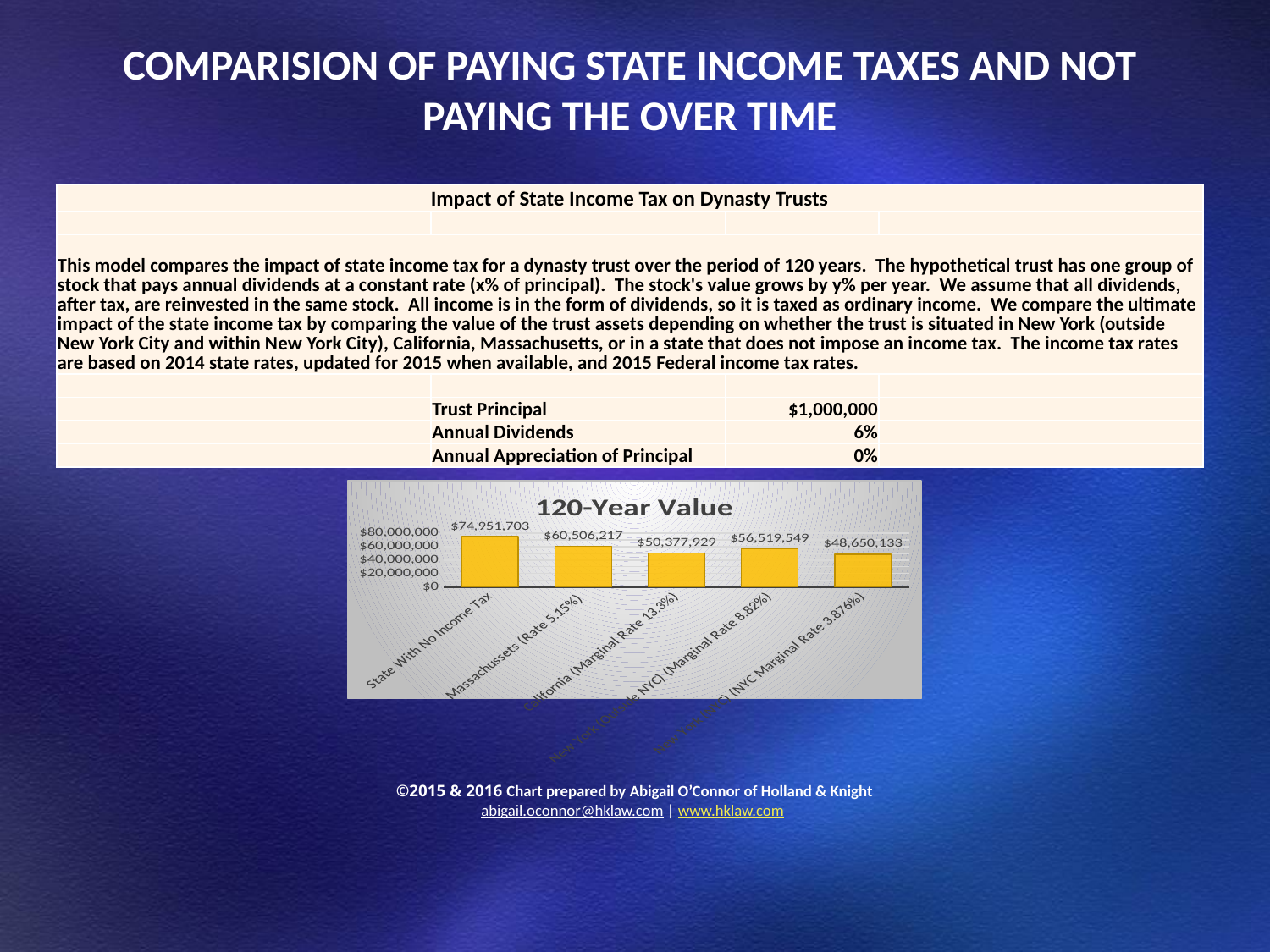
Which is larger, the 120-year value for Massachusetts (Rate 5.15%) or for California (Marginal Rate 13.3%)? Massachusetts (Rate 5.15%) Is the 120-year value for California (Marginal Rate 13.3%) greater or less than $60,000,000? less What is the difference between the 120-year value for State With No Income Tax and the bar labelled NYC Marginal Rate 3.876%? $26,301,570 What is the title of the chart? 120-Year Value What is the 120-year value for the bar labelled with NYC Marginal Rate 3.876%? $48,650,133 What is the 120-year value for State With No Income Tax? $74,951,703 How many bars are plotted in the 120-Year Value chart? 5 What is the 120-year value for California (Marginal Rate 13.3%)? $50,377,929 What type of chart is shown on the slide? Bar chart Which category has the highest 120-year value? State With No Income Tax What is the 120-year value for Massachusetts (Rate 5.15%)? $60,506,217 What is the 120-year value for the bar labelled with Marginal Rate 8.82%? $56,519,549